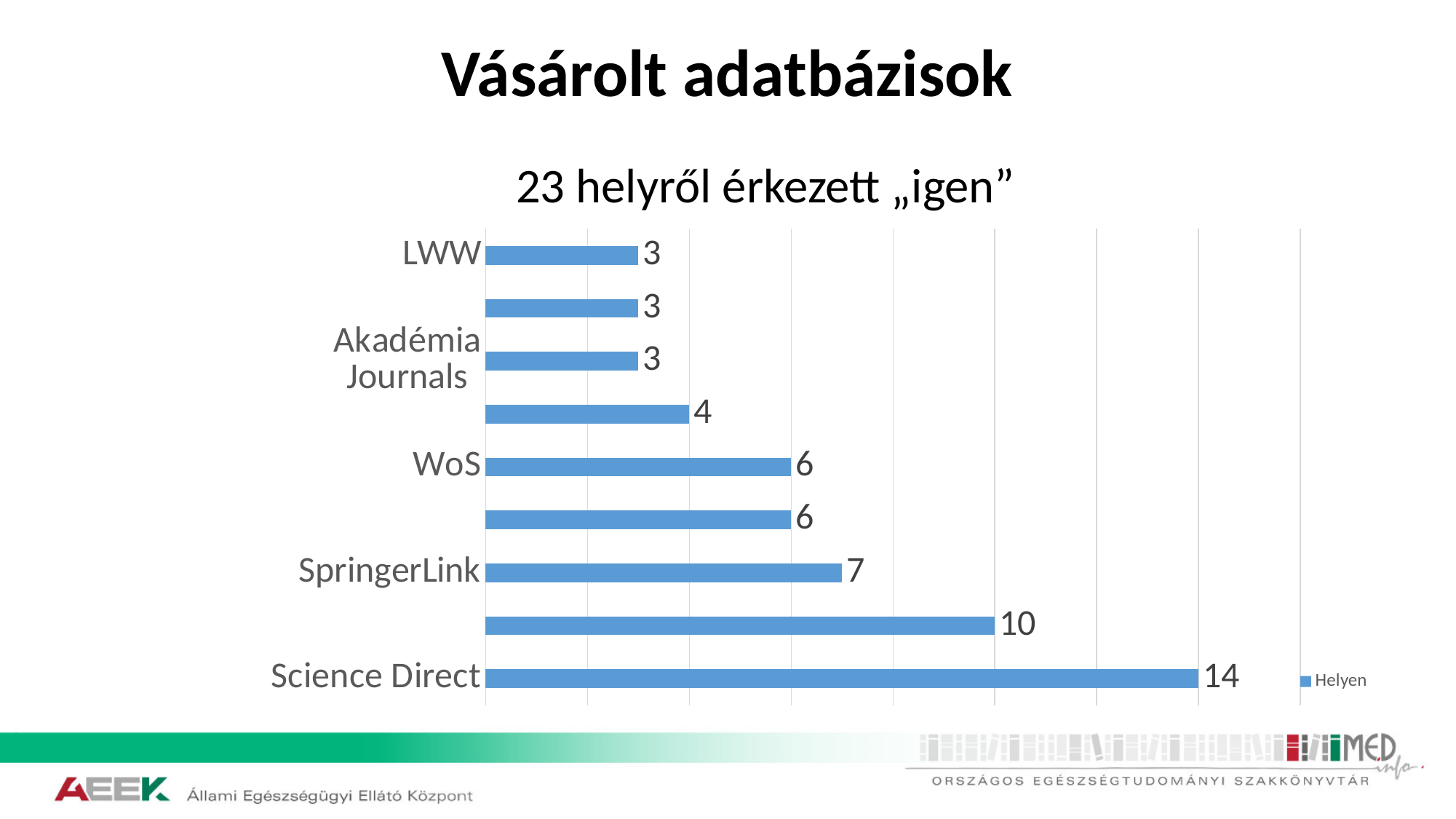
Which category has the highest value? Science Direct Which is larger, the value for SpringerLink or the value for WoS? SpringerLink What is the value for Science Direct? 14 What is the value for Akadémia Journals? 3 What is the value for SpringerLink? 7 How many bars are plotted in the chart? 9 What is the value for WoS? 6 What is the difference between the values for WoS and LWW? 3 What is the title of the chart? 23 helyről érkezett „igen” What is the difference between the values for Science Direct and SpringerLink? 7 What is the value for LWW? 3 What kind of chart is shown on the slide? Bar chart